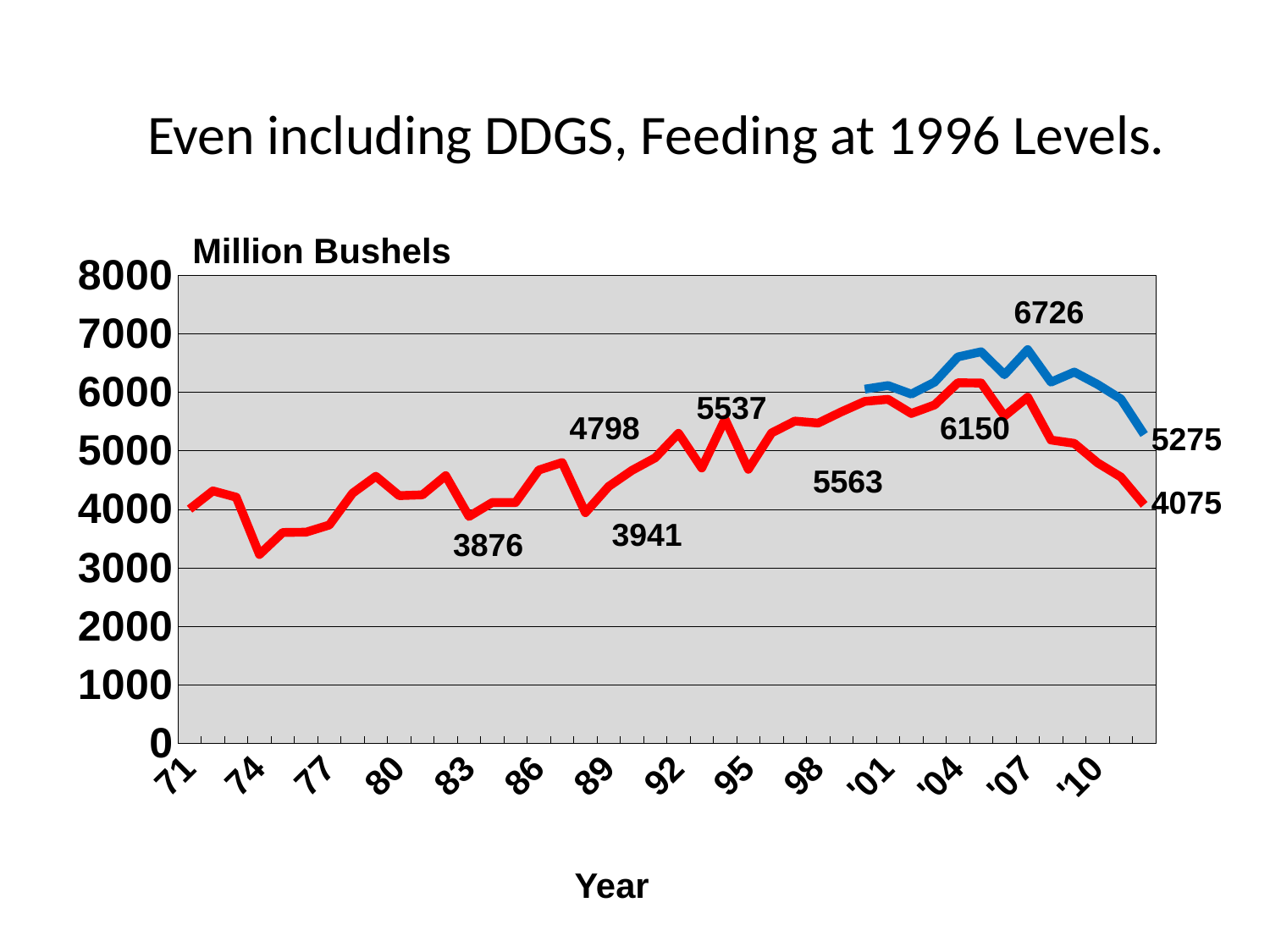
How many lines are plotted on the chart? 2 What is the lowest value labeled on the chart? 3876 What unit is given for the vertical axis of the chart? Million Bushels What is the highest value labeled on the chart? 6726 What kind of chart is shown on the slide? line chart What is the final labeled value of the red line at the right end of the chart? 4075 What is the difference between the final labeled values of the blue line (5275) and the red line (4075)? 1200 Does the red line rise or fall between '07 and the end of the chart? fall What is the final labeled value of the blue line at the right end of the chart? 5275 At the right end of the chart, which line is higher, the blue line or the red line? blue line What is the title of the chart on the slide? Even including DDGS, Feeding at 1996 Levels. Is the value of the red line in '74 greater or less than 4000? less